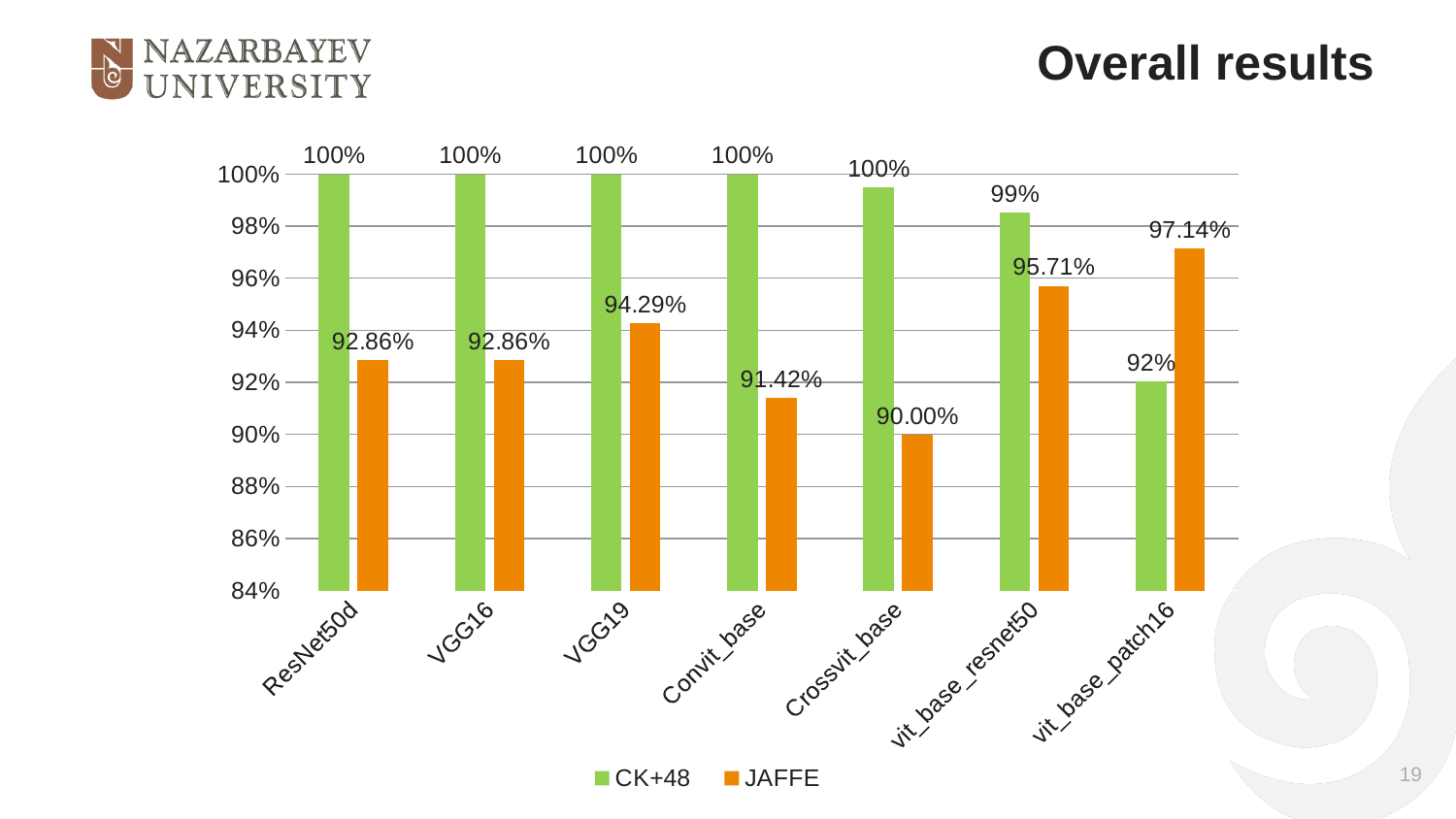
What is the JAFFE value for Crossvit_base? 90.00% What kind of chart is shown on the slide? Bar chart Which model has the lowest CK+48 value? vit_base_patch16 How many series does the legend list? 2 Which model has the highest JAFFE value? vit_base_patch16 How many models are shown on the x axis? 7 What is the JAFFE value for VGG19? 94.29% What is the difference between the CK+48 and JAFFE values for ResNet50d? 7.14% Which model has the lowest JAFFE value? Crossvit_base For vit_base_patch16, which is larger: the CK+48 value or the JAFFE value? JAFFE What is the CK+48 value for vit_base_patch16? 92% What is the CK+48 value for vit_base_resnet50? 99%